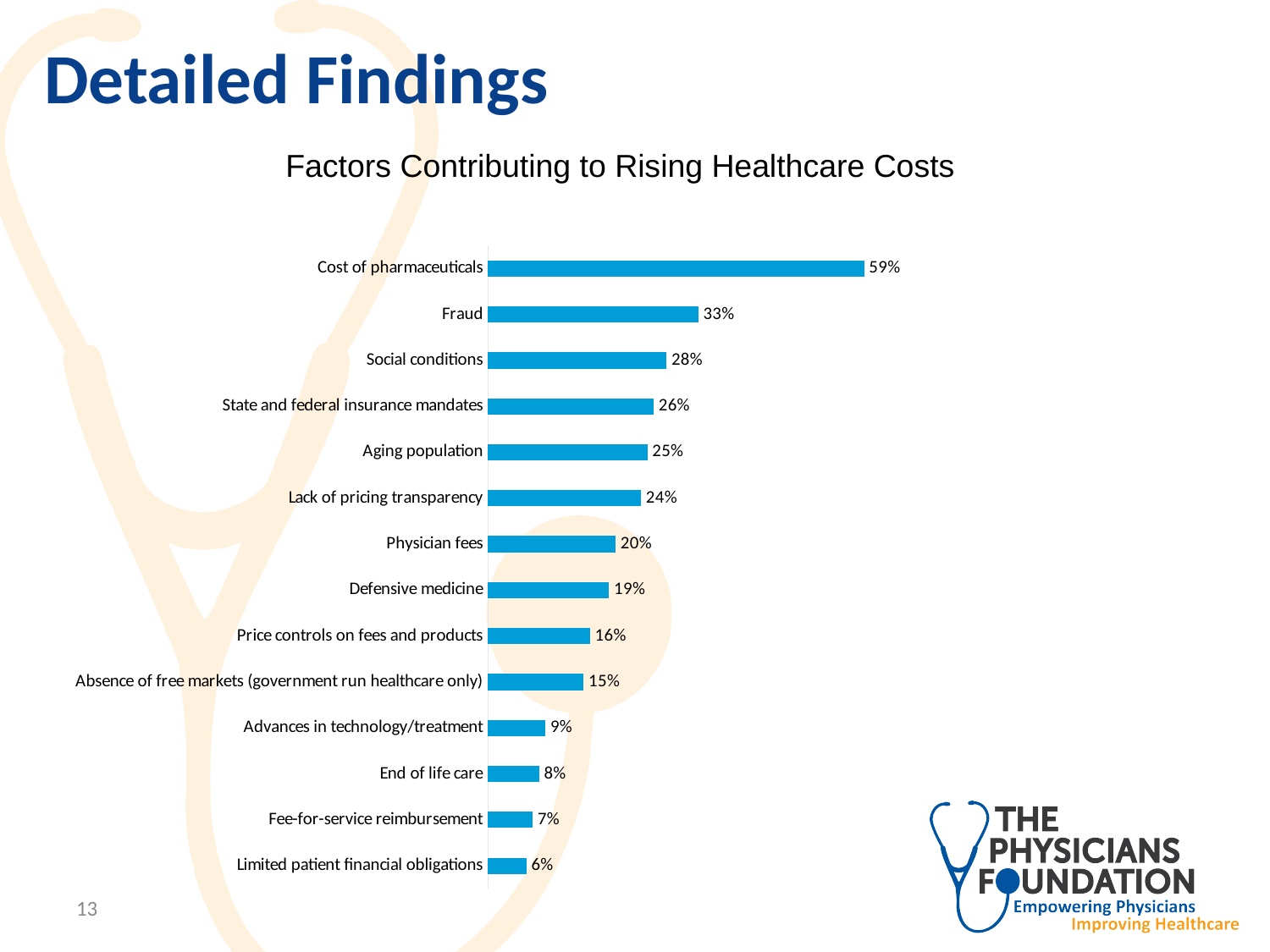
What is the title of the chart? Factors Contributing to Rising Healthcare Costs How many factors are listed in the chart? 14 What percentage is shown for Cost of pharmaceuticals? 59% What kind of chart is shown on the slide? Bar chart What is the value for Aging population? 25% What is the difference between the values for Social conditions and Physician fees? 8% What percentage is shown for Defensive medicine? 19% Which factor has the highest value? Cost of pharmaceuticals Which is larger, the value for Fraud or the value for Lack of pricing transparency? Fraud Which is larger, the value for End of life care or the value for Advances in technology/treatment? Advances in technology/treatment What is the difference between the values for Cost of pharmaceuticals and Fraud? 26% Which factor has the lowest value? Limited patient financial obligations